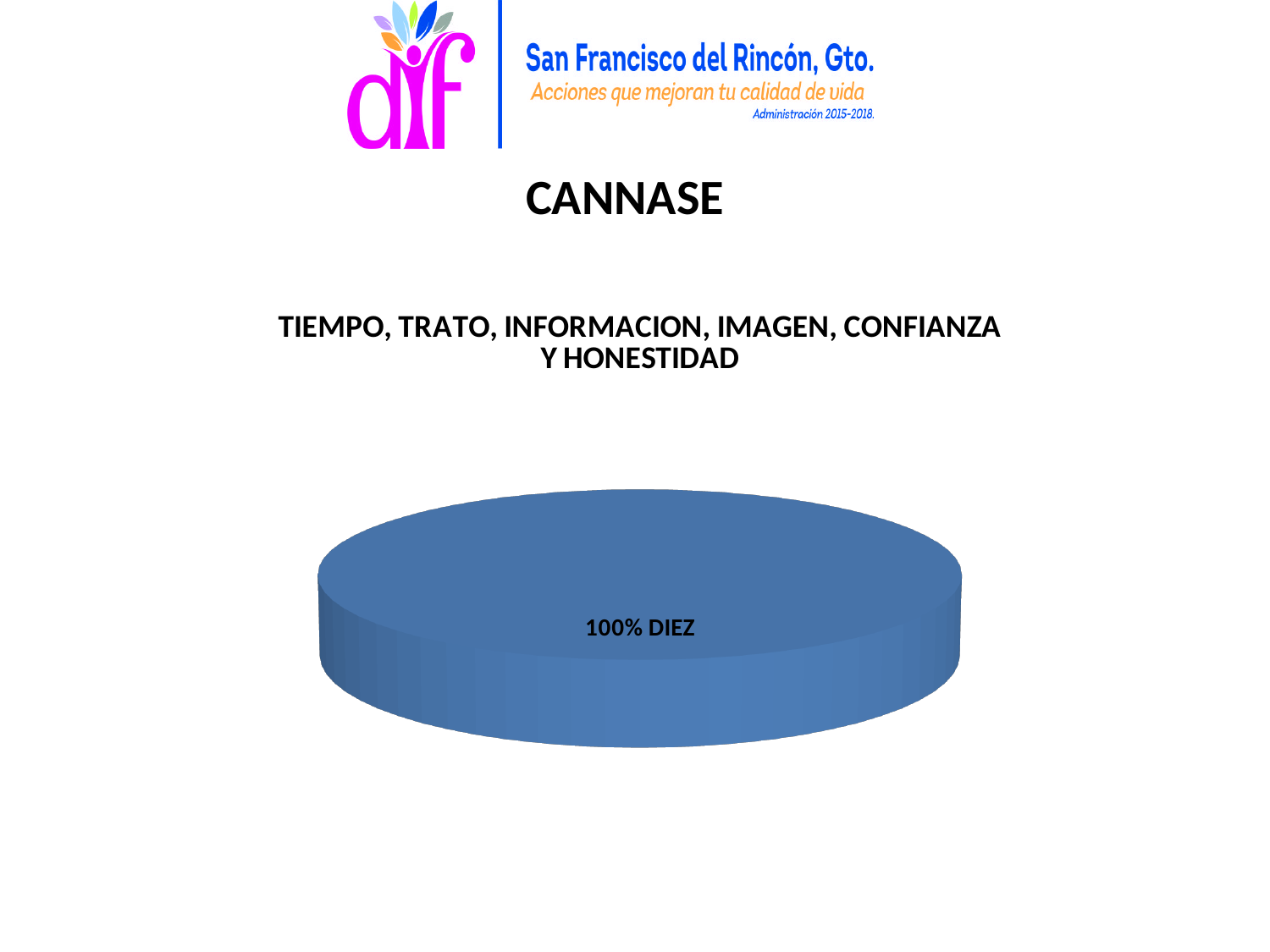
Which category makes up the entire pie? DIEZ What colour is the pie slice? blue What share of the pie does the DIEZ slice represent? 100% What is the label printed on the pie slice? 100% DIEZ What kind of chart is shown on the slide? pie chart How many slices does the pie chart have? 1 What is the title of the chart? TIEMPO, TRATO, INFORMACION, IMAGEN, CONFIANZA Y HONESTIDAD